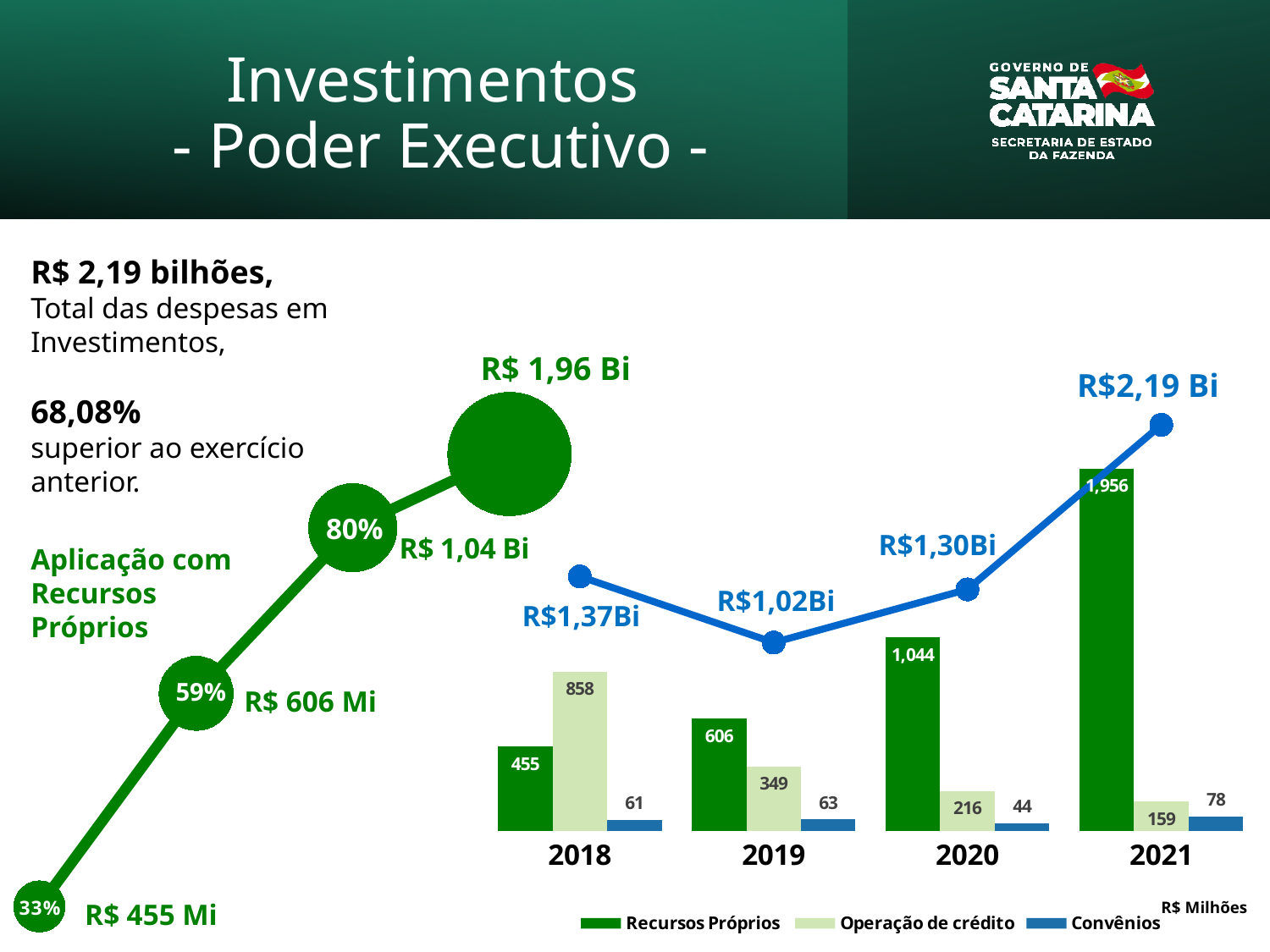
How many series does the legend of the bar chart list? 3 In the bar chart, what is the difference between Recursos Próprios in 2021 and in 2020? 912 In the bar chart, what is the value of Operação de crédito for 2018? 858 How many years are shown on the x axis of the bar chart? 4 In the bar chart for 2018, which is larger: Recursos Próprios or Operação de crédito? Operação de crédito In the bar chart, do the values for Operação de crédito rise or fall from 2018 to 2021? fall What total value is labelled on the blue line for 2019? R$1,02Bi In the bar chart, what is the value of Convênios for 2021? 78 In the bar chart, which year has the highest value for Recursos Próprios? 2021 In the bar chart, which year has the lowest value for Convênios? 2020 In the bar chart, what is the value of Recursos Próprios for 2020? 1,044 What kind of chart is used to show Recursos Próprios, Operação de crédito and Convênios by year? bar chart